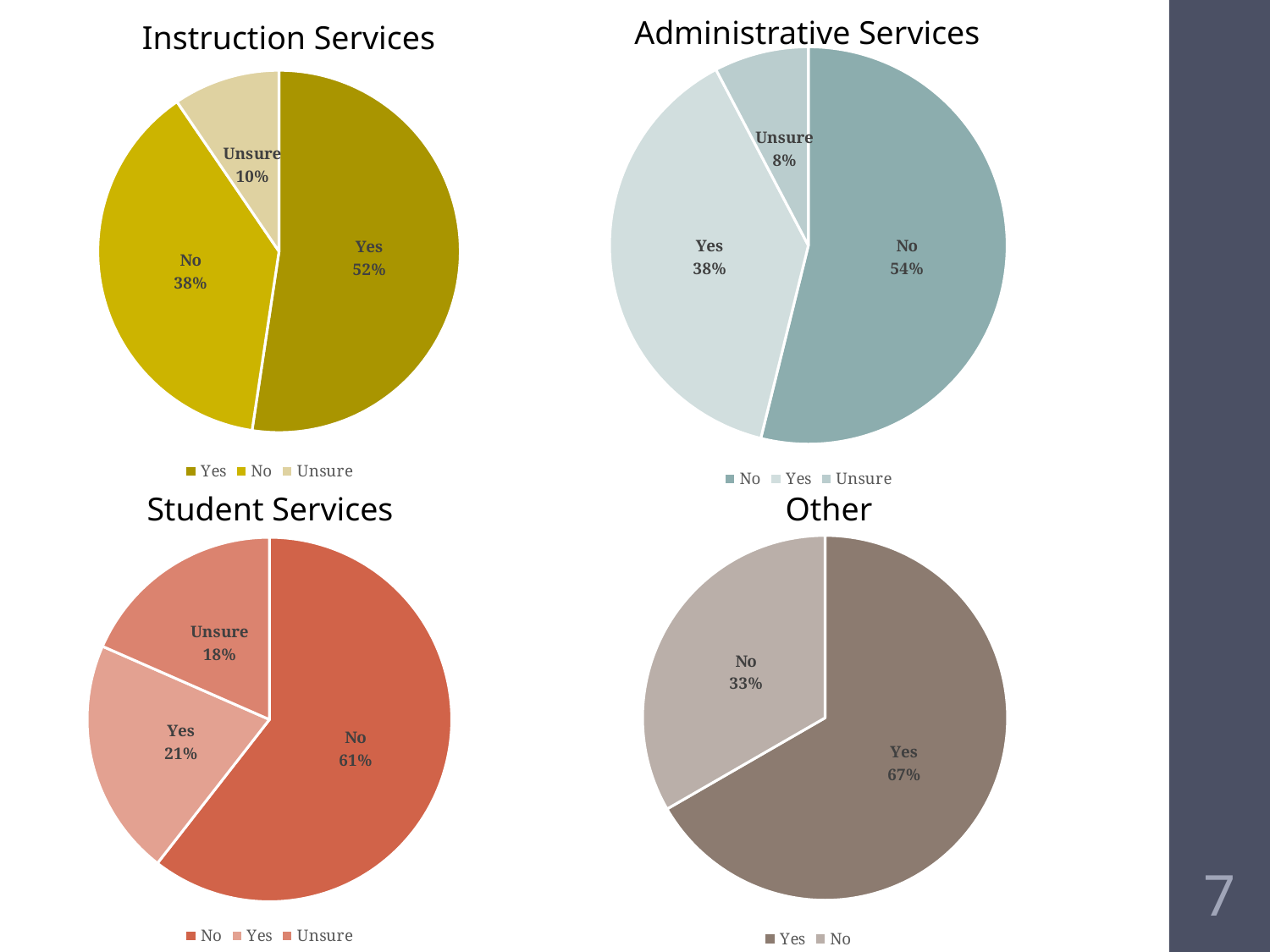
In the Administrative Services chart, which category has the largest slice? No What type of chart is the Instruction Services chart? Pie chart How many slices does the Other chart have? 2 In the Student Services chart, which category has the smallest slice? Unsure In the Administrative Services chart, what percentage is the Unsure slice? 8% In the Instruction Services chart, what percentage is the Yes slice? 52% In the Instruction Services chart, what is the difference between the Yes and No percentages? 14% How many entries does the legend of the Administrative Services chart list? 3 In the Other chart, what is the difference between the Yes and No percentages? 34% In the Other chart, what percentage is the Yes slice? 67% In the Student Services chart, which is larger, Yes or Unsure? Yes In the Student Services chart, what percentage is the No slice? 61%